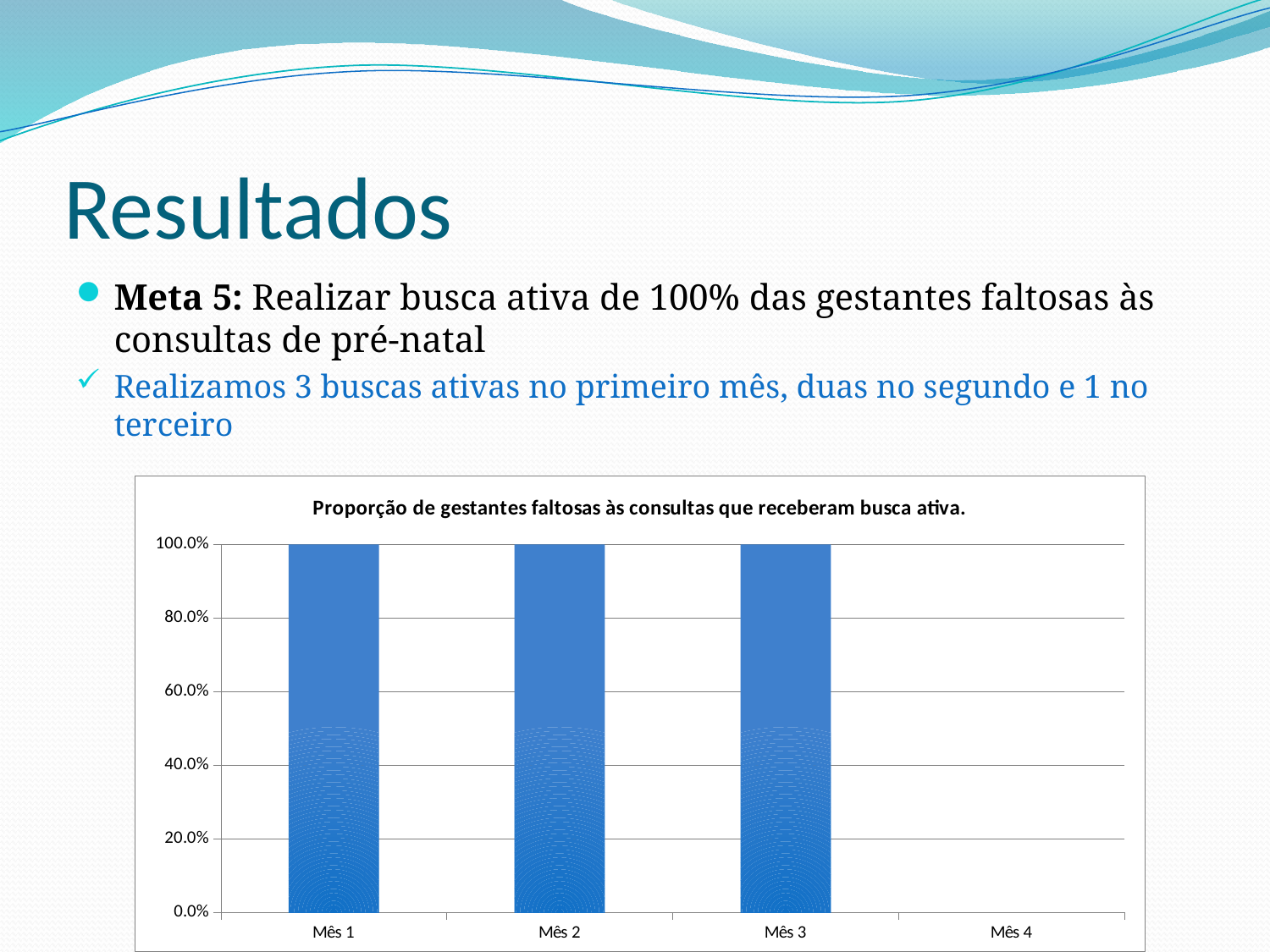
How many categories are shown on the x axis of the chart? 4 Which category has no visible bar in the chart? Mês 4 Do the values change between Mês 1 and Mês 3? No, they stay the same What is the highest value shown on the y axis of the chart? 100.0% What is the value for Mês 3? 100.0% Is the value for Mês 3 greater or less than 60.0%? greater What is the value for Mês 1? 100.0% What is the difference between the values for Mês 1 and Mês 3? 0.0% What type of chart is shown on the slide? bar chart What is the value for Mês 2? 100.0% Is the value for Mês 2 greater or less than 80.0%? greater What is the title of the chart? Proporção de gestantes faltosas às consultas que receberam busca ativa.